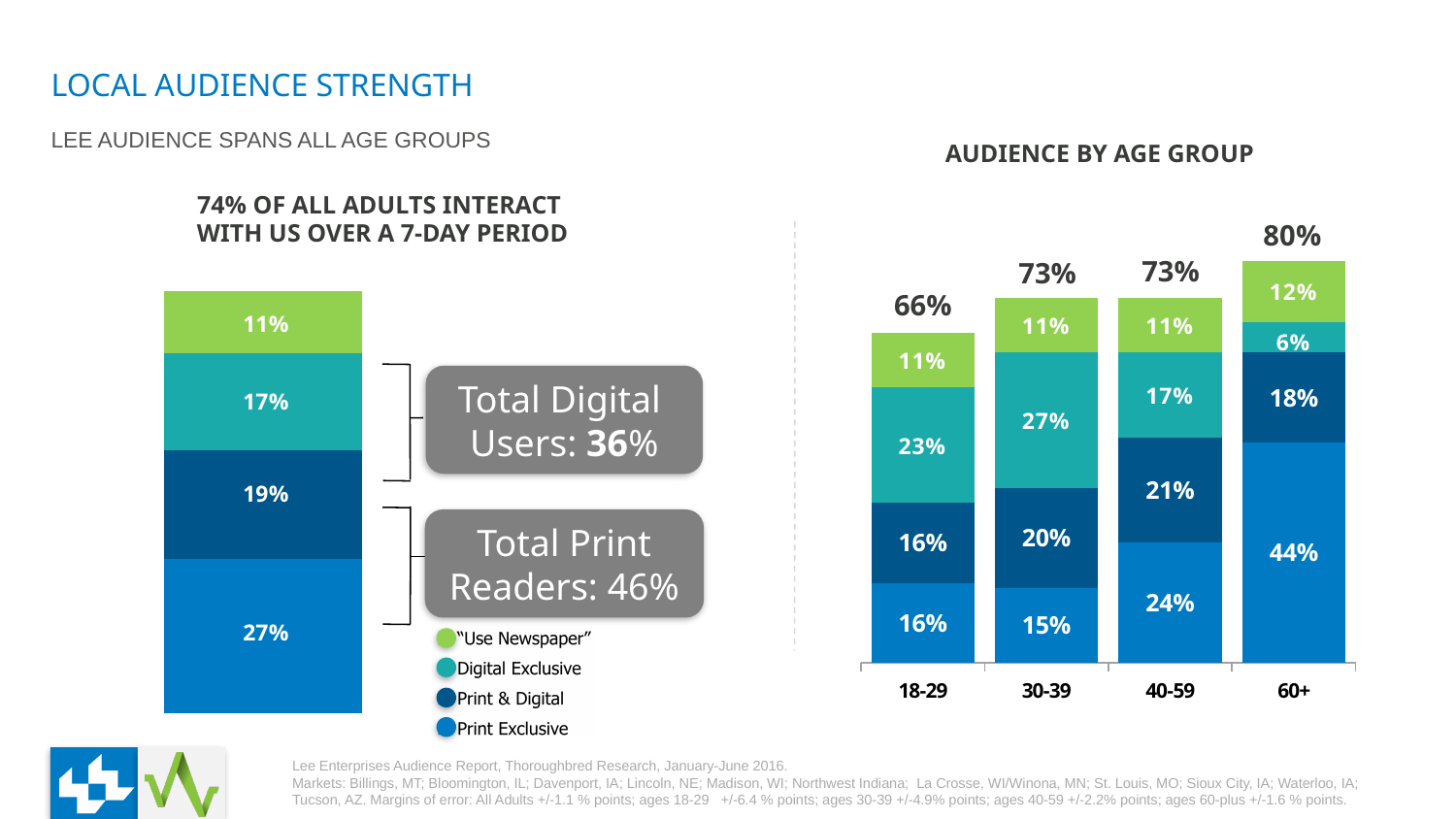
In the 'Audience by Age Group' chart, what is the Print Exclusive value for the 40-59 age group? 24% In the left chart under '74% of all adults interact with us over a 7-day period', what is the Print Exclusive value? 27% In the 'Audience by Age Group' chart, is the Digital Exclusive value larger for 30-39 or for 60+? 30-39 In the 'Audience by Age Group' chart, what is the total for the 60+ age group? 80% In the 'Audience by Age Group' chart, what is the 'Use Newspaper' value for the 60+ age group? 12% How many age groups are shown in the 'Audience by Age Group' chart? 4 In the 'Audience by Age Group' chart, which age group has the highest total? 60+ In the 'Audience by Age Group' chart, what is the difference between the Print Exclusive values for 60+ and 18-29? 28% In the left chart under '74% of all adults interact with us over a 7-day period', what is the total of the Digital Exclusive and Print & Digital segments? 36% How many series does the legend list? 4 In the 'Audience by Age Group' chart, which age group has the lowest total? 18-29 What kind of chart is the 'Audience by Age Group' chart? Stacked bar chart